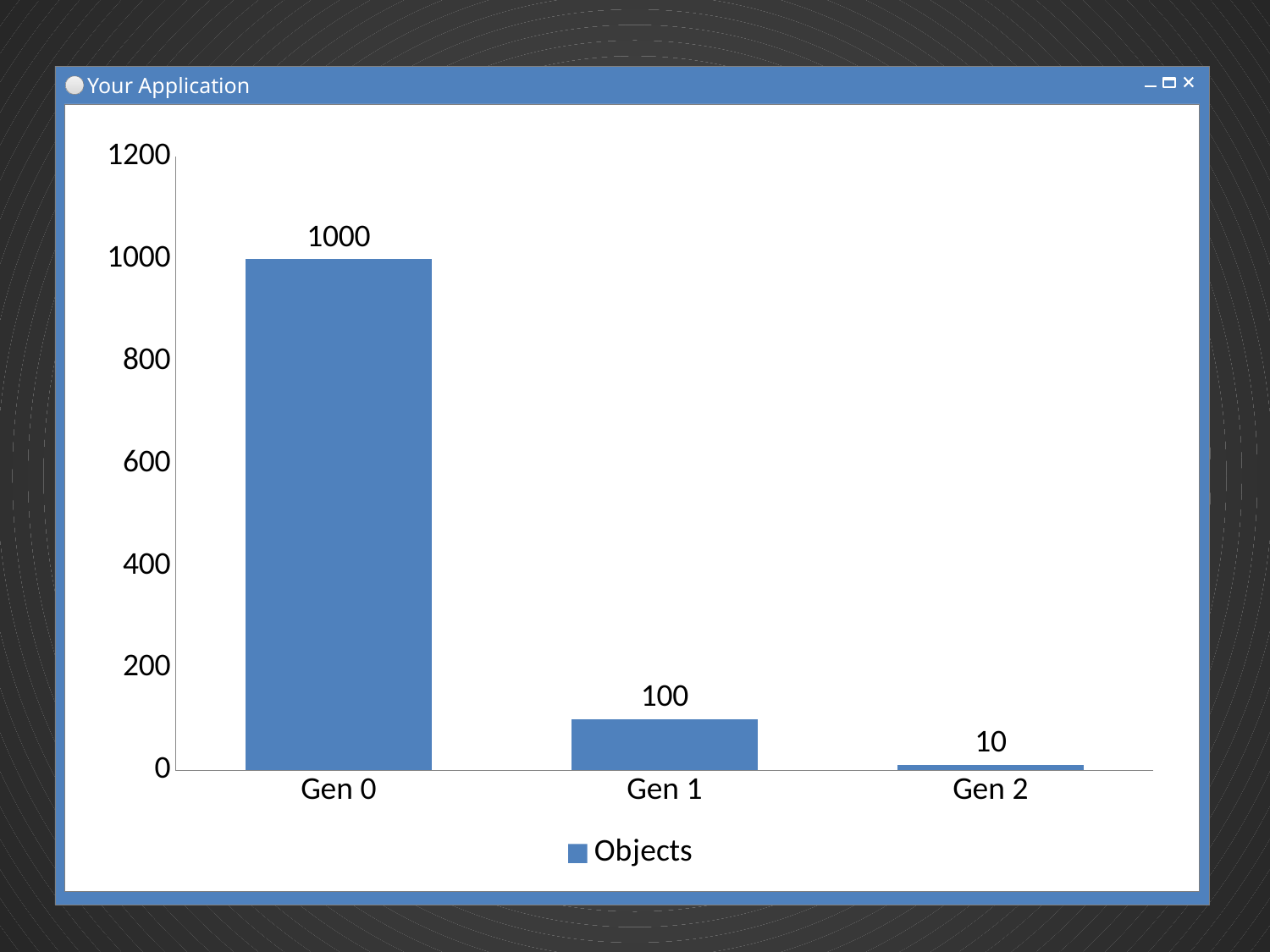
What is the difference between the values for Gen 1 and Gen 2? 90 What is the value for Gen 2? 10 What is the value for Gen 0? 1000 Which category has the highest value? Gen 0 What is the difference between the values for Gen 0 and Gen 1? 900 Do the values rise or fall from Gen 0 to Gen 2? fall Which category has the lowest value? Gen 2 What kind of chart is shown? bar chart How many categories are shown on the x axis? 3 What is the value for Gen 1? 100 Which is larger, the value for Gen 1 or the value for Gen 2? Gen 1 Is the value for Gen 0 greater or less than 800? greater